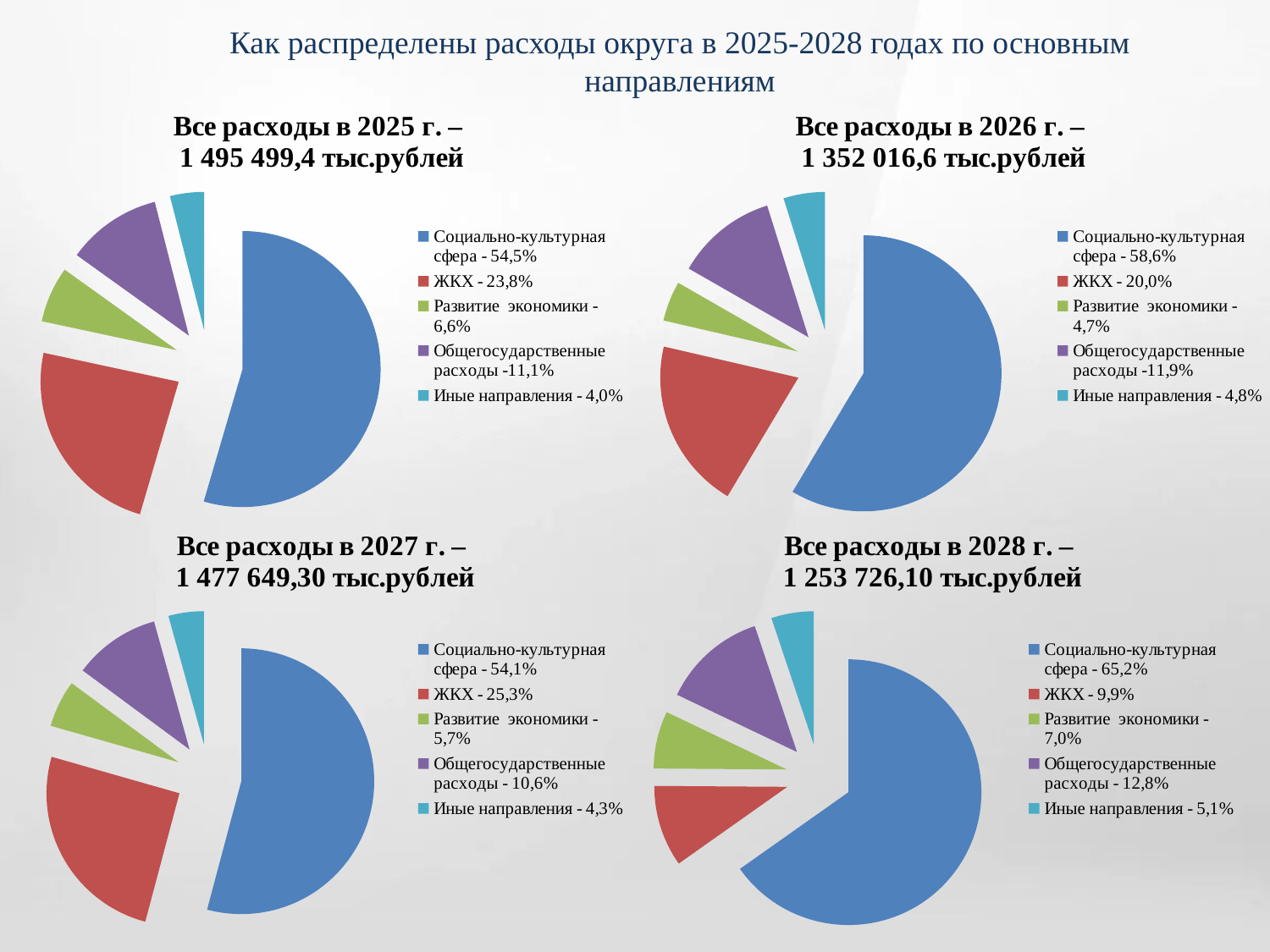
In the 2025 pie chart (top left), what share of expenditures goes to ЖКХ? 23,8% What type of chart is used for the 2025 expenditures (top left)? Pie chart In the 2026 pie chart (top right), which is larger: the share for Развитие экономики or the share for Иные направления? Иные направления In the 2027 pie chart (bottom left), what share is shown for Развитие экономики? 5,7% In the 2026 pie chart (top right), what share is shown for Социально-культурная сфера? 58,6% What total expenditure amount is stated in the title of the 2026 chart (top right)? 1 352 016,6 тыс.рублей In the 2025 pie chart (top left), which category has the smallest share? Иные направления How many pie charts are shown on the slide? 4 In the 2028 pie chart (bottom right), what is the difference in percentage points between Социально-культурная сфера and ЖКХ? 55,3 In the 2027 pie chart (bottom left), which category has the largest share? Социально-культурная сфера How many categories does the 2027 pie chart (bottom left) show? 5